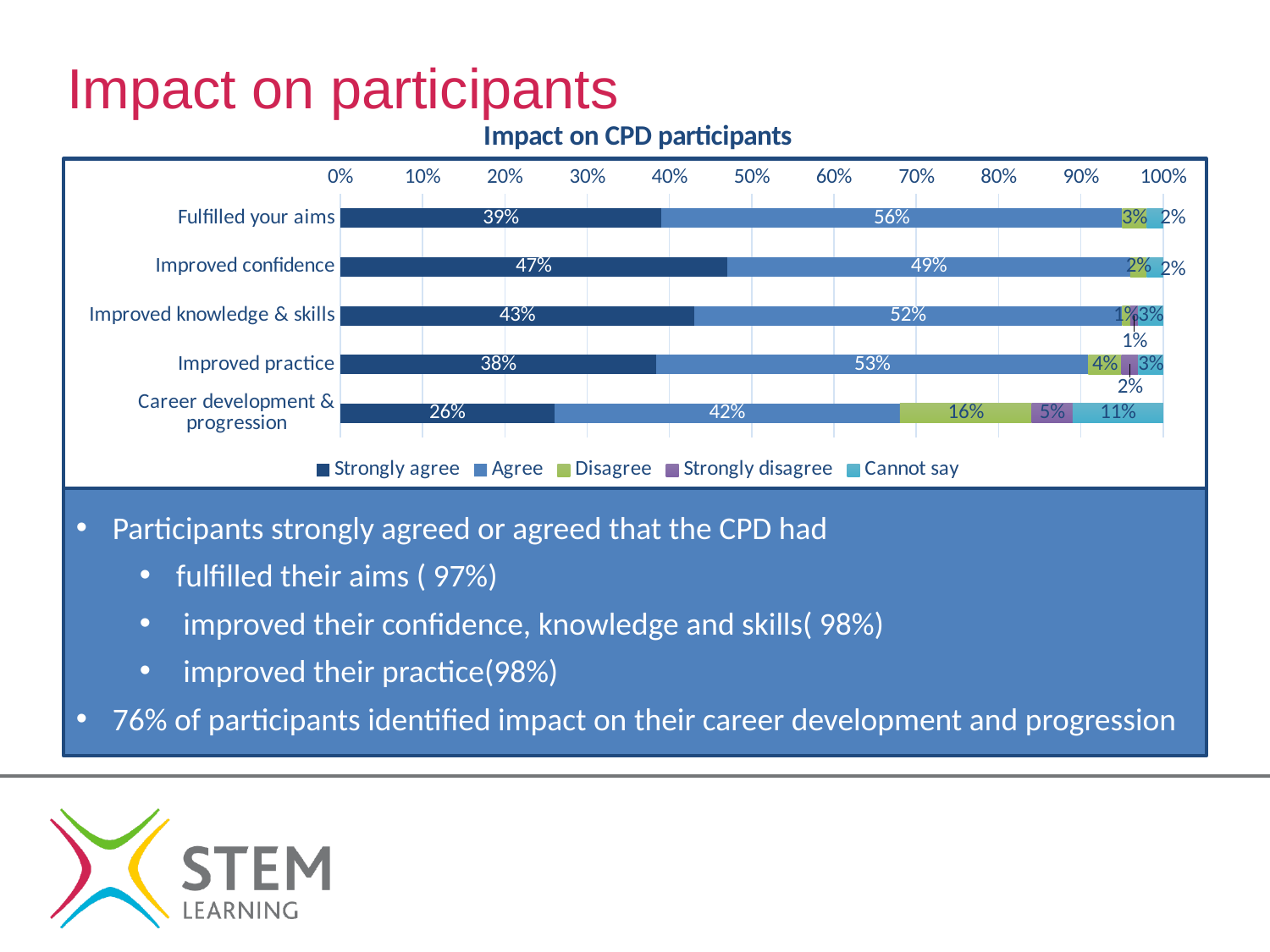
What is the title of the chart? Impact on CPD participants What is the Disagree value for Career development & progression? 16% Which category has the lowest Strongly agree value? Career development & progression What type of chart is shown on the slide? Stacked bar chart How many categories are shown on the chart? 5 What is the difference between the Agree values for Improved practice and Improved confidence? 4% How many series does the legend list? 5 What is the Agree value for Fulfilled your aims? 56% What is the Strongly agree value for Improved confidence? 47% Which category has the highest Strongly agree value? Improved confidence Which is larger: the Strongly agree value for Improved knowledge & skills or for Improved practice? Improved knowledge & skills What is the Cannot say value for Career development & progression? 11%